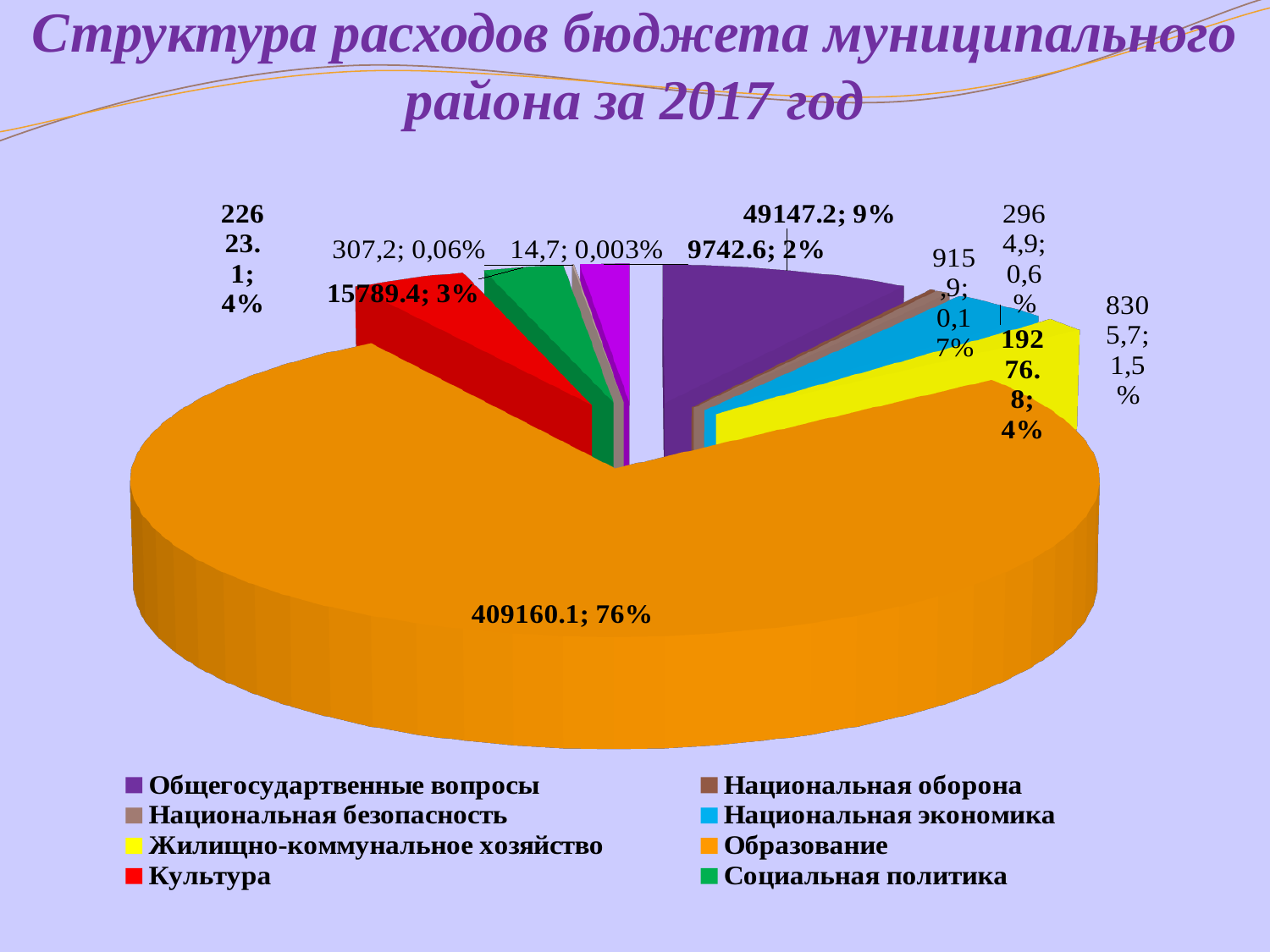
What share of the pie does Образование have? 76% Which is larger, the share for Общегосударственные вопросы or the share for Культура? Общегосударственные вопросы What share of the pie does Культура have? 4% What is the smallest percentage share labelled on the pie? 0,003% What share of the pie does Общегосударственные вопросы have? 9% What is the title of the chart? Структура расходов бюджета муниципального района за 2017 год How many entries does the legend list? 8 What value is labelled for Образование? 409160.1 What kind of chart is shown on the slide? pie chart What is the difference in percentage points between the share for Образование and the share for Общегосударственные вопросы? 67 Which category has the largest share of the pie? Образование What value is labelled for Общегосударственные вопросы? 49147.2